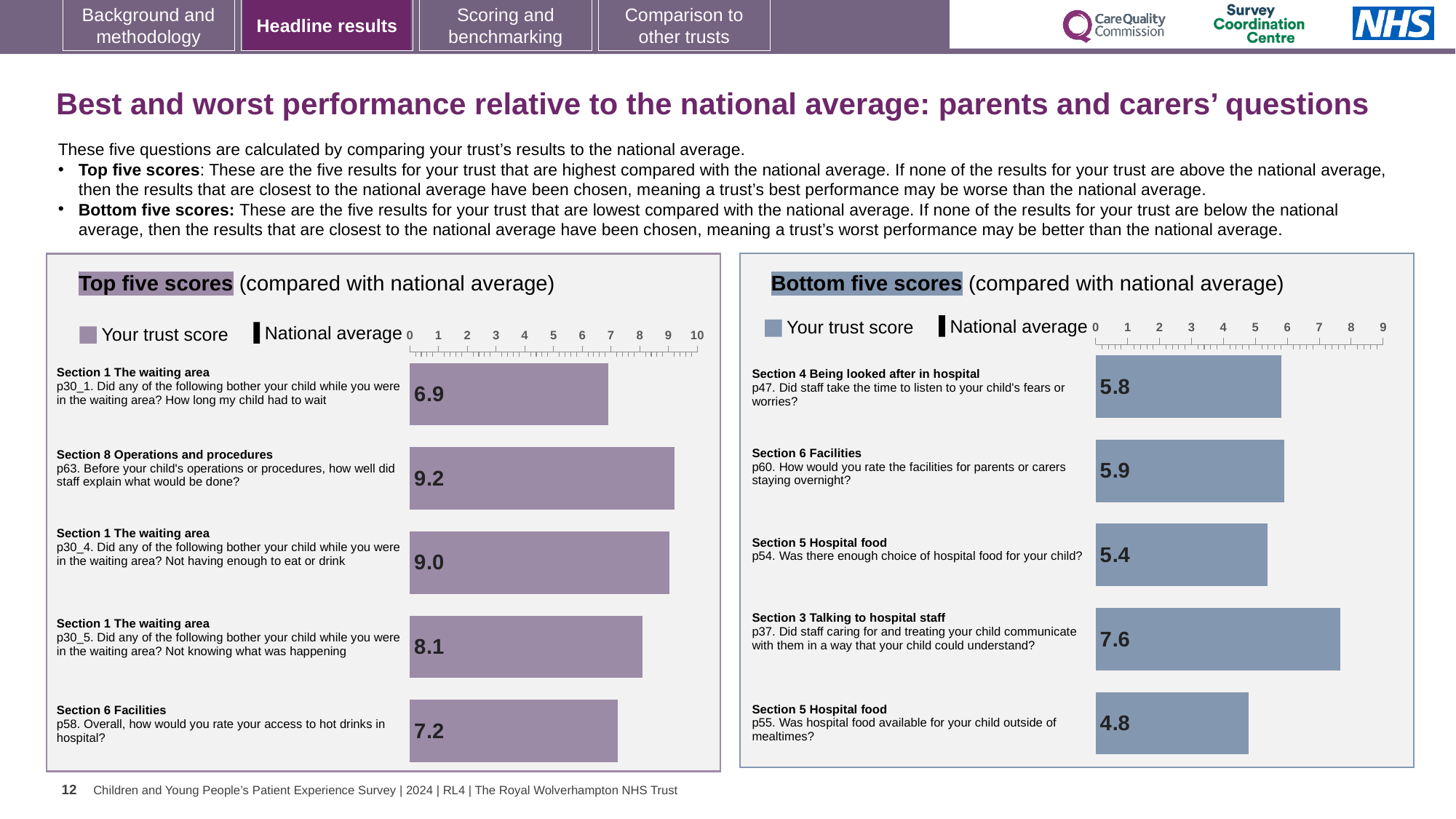
In the 'Top five scores' chart, what is the difference between the trust scores for p63 and p30_1? 2.3 In the 'Bottom five scores' chart, which has the larger trust score: p54 (enough choice of hospital food) or p60 (facilities for parents or carers staying overnight)? p60 In the 'Bottom five scores' chart, what is the trust score for p37 (staff communicating in a way the child could understand)? 7.6 In the 'Bottom five scores' chart, which question has the highest trust score? p37. Did staff caring for and treating your child communicate with them in a way that your child could understand? In the 'Top five scores' chart, what is the trust score for p58 (access to hot drinks in hospital)? 7.2 In the 'Top five scores' chart, what is the trust score for p63 (how well did staff explain what would be done before operations or procedures)? 9.2 What type of chart is used in the 'Top five scores' panel? Bar chart In the 'Bottom five scores' chart, what is the trust score for p55 (hospital food available outside of mealtimes)? 4.8 In the 'Top five scores' chart, which question has the lowest trust score? p30_1. Did any of the following bother your child while you were in the waiting area? How long my child had to wait How many bars are shown in the 'Bottom five scores' chart? 5 In the 'Bottom five scores' chart, which question has the lowest trust score? p55. Was hospital food available for your child outside of mealtimes? In the 'Top five scores' chart, which question has the highest trust score? p63. Before your child's operations or procedures, how well did staff explain what would be done?